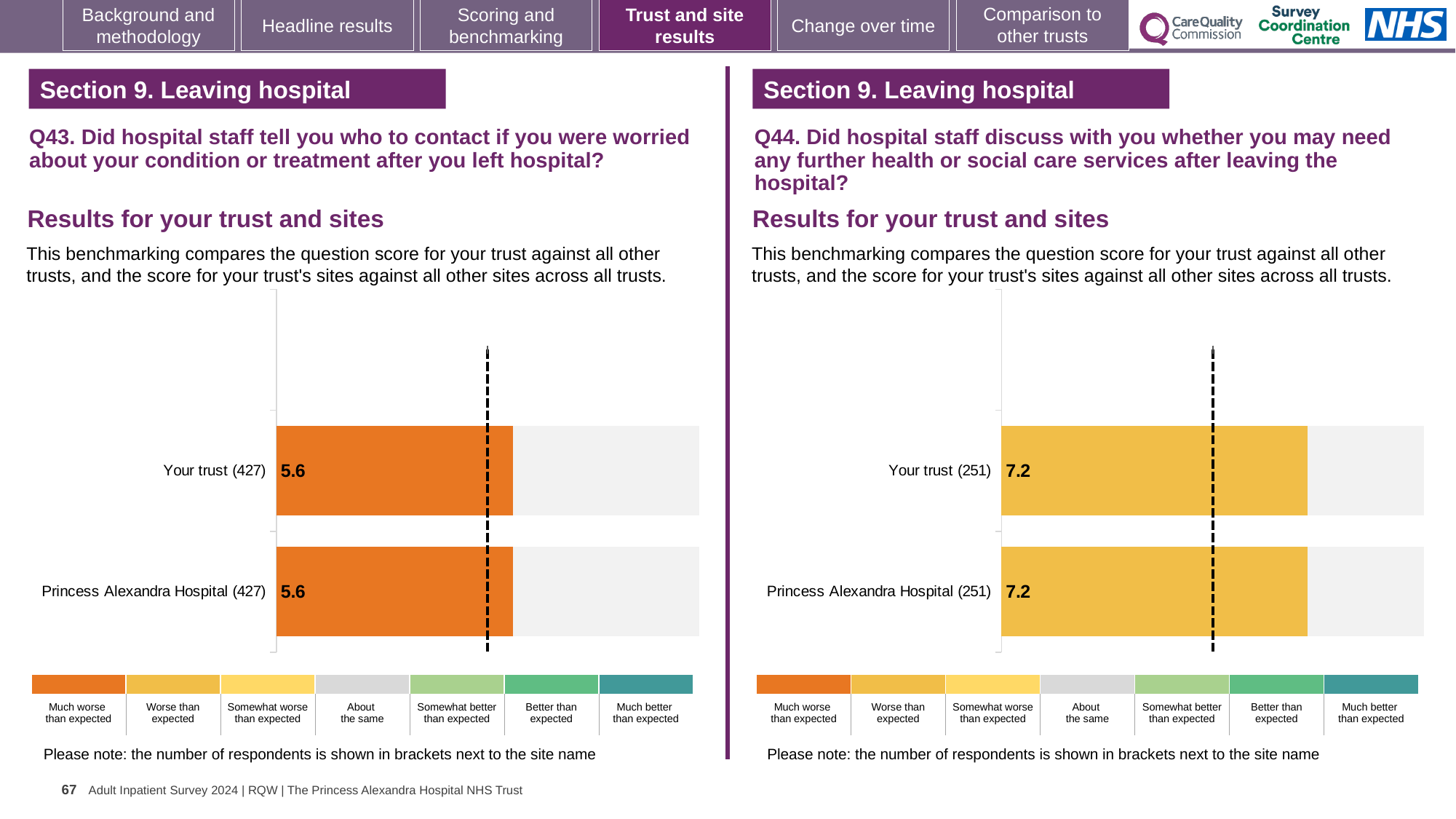
In the Q43 chart on the left, which benchmark category does the colour of the bars correspond to according to the legend? Much worse than expected In the Q43 chart on the left, how many respondents are shown in brackets next to Your trust? 427 In the Q44 chart on the right, what is the score for Princess Alexandra Hospital? 7.2 In the Q43 chart on the left, what is the difference between the score for Your trust and the score for Princess Alexandra Hospital? 0.0 In the Q44 chart on the right, what is the score for Your trust? 7.2 In the Q44 chart on the right, how many respondents are shown in brackets next to Princess Alexandra Hospital? 251 In the Q43 chart on the left, what is the score for Your trust? 5.6 In the Q44 chart on the right, which benchmark category does the colour of the bars correspond to according to the legend? Worse than expected In the Q43 chart on the left, what is the score for Princess Alexandra Hospital? 5.6 Is the score for Your trust in the Q44 chart on the right larger or smaller than the score for Your trust in the Q43 chart on the left? Larger What kind of chart is used in the Q43 chart on the left? Bar chart In the Q44 chart on the right, how many bars are plotted? 2